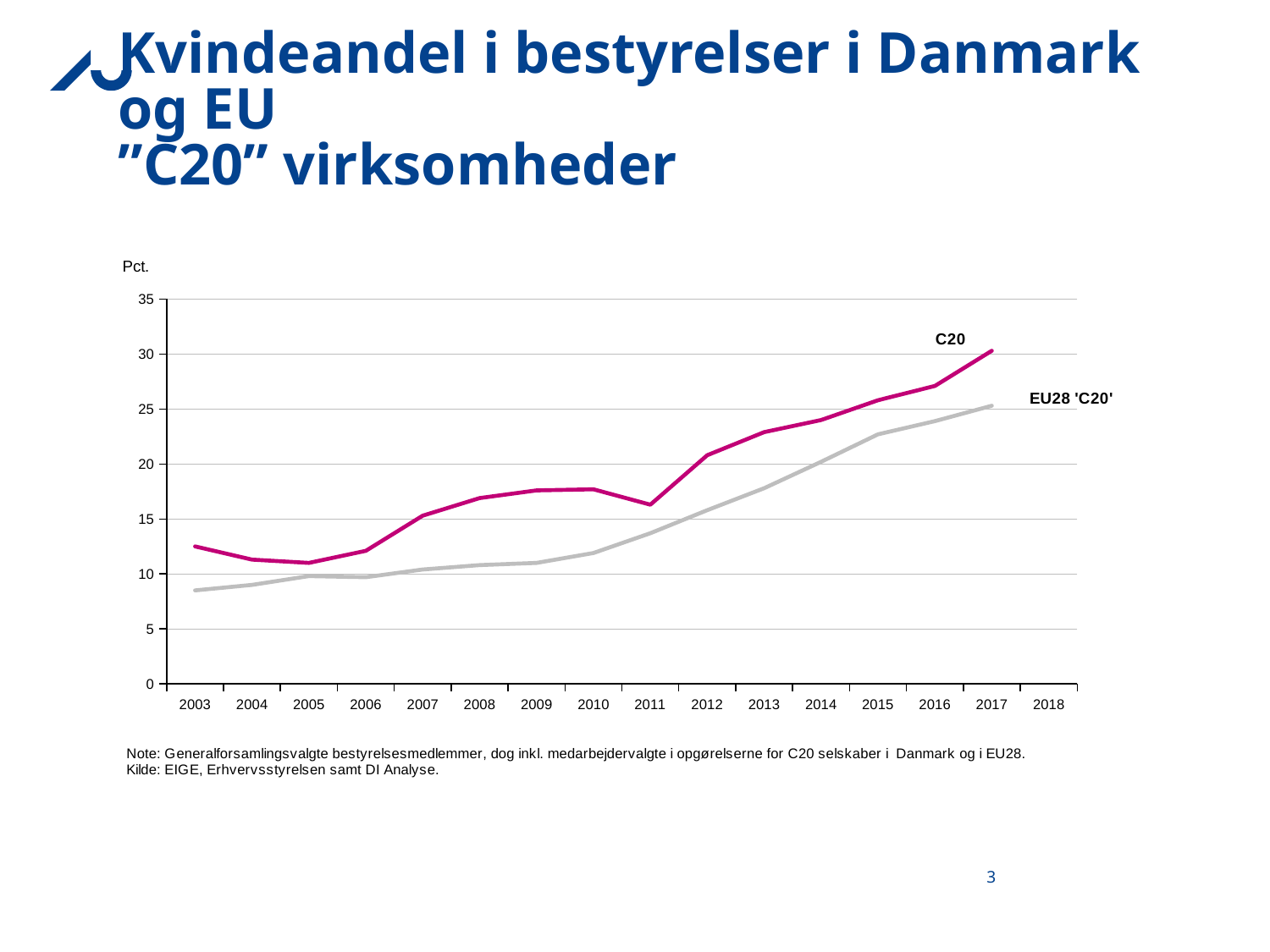
Is the value for C20 in 2017 greater or less than 25? greater What unit label is shown above the y axis? Pct. What kind of chart is shown on the slide? Line chart Is the value for EU28 'C20' in 2017 greater or less than 30? less Which series has the higher value in 2010, C20 or EU28 'C20'? C20 How many series are plotted in the chart? 2 Is the value for C20 in 2013 greater or less than 20? greater Does the EU28 'C20' line generally rise or fall from 2003 to 2017? rise What are the names of the two series plotted in the chart? C20 and EU28 'C20' How many years are labelled on the x axis? 16